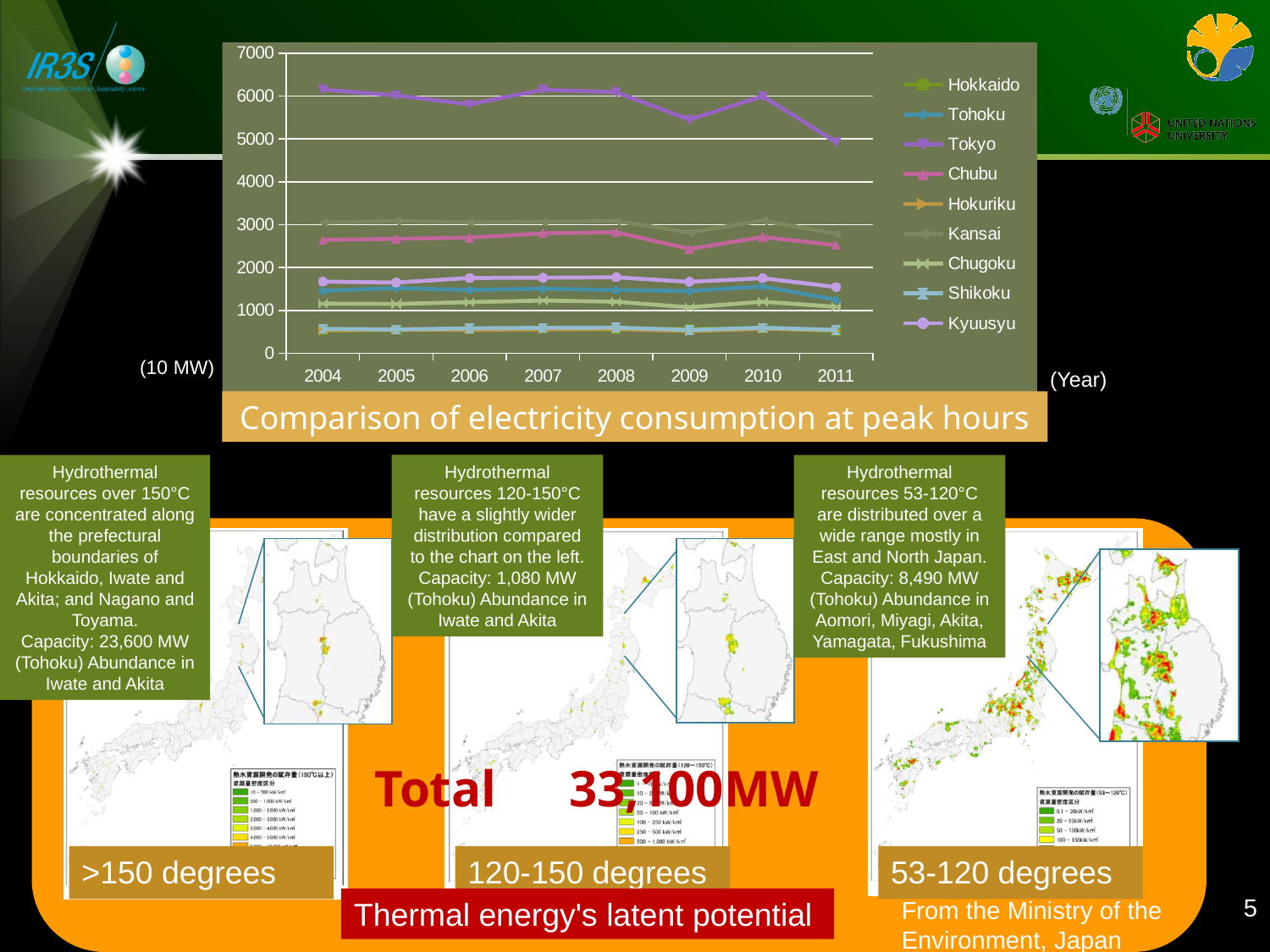
Which is larger in 2011, the value for Tokyo or the value for Chubu? Tokyo Is the value for Kyuusyu in 2010 greater or less than 1000? greater Is the value for Tokyo in 2009 greater or less than 6000? less How many series does the chart's legend list? 9 What is the title of the chart on the slide? Comparison of electricity consumption at peak hours Which region has the highest electricity consumption at peak hours across the years shown? Tokyo Does the value for Tokyo rise or fall from 2004 to 2011? fall Is the value for Tokyo in 2004 greater or less than 6000? greater How many years are shown along the x axis of the chart? 8 What kind of chart is shown on the slide? line chart